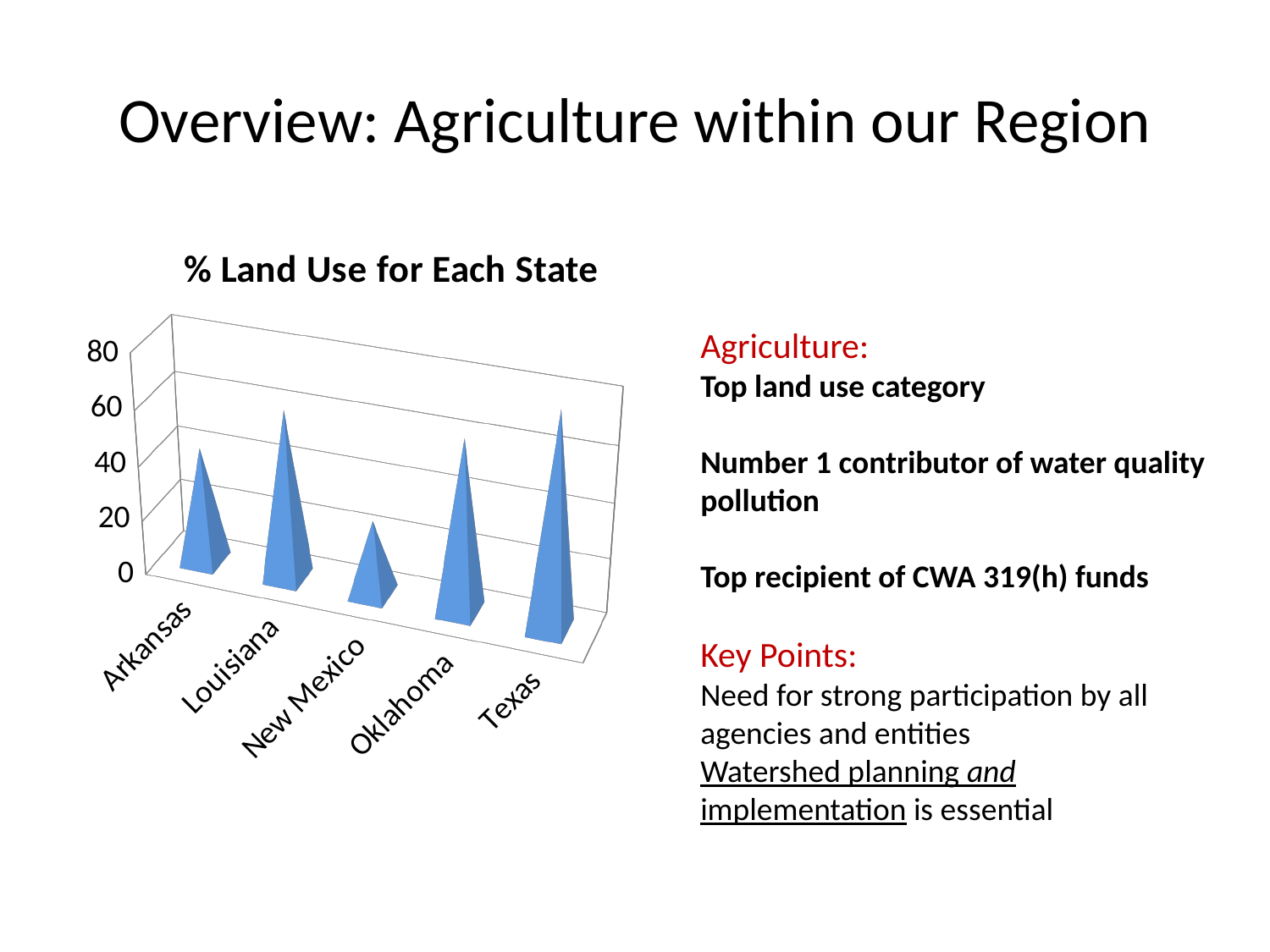
Which has the larger value, Louisiana or New Mexico? Louisiana Is the value for Texas greater or less than 40? greater What is the highest value labelled on the vertical axis of the chart? 80 Which has the larger value, Texas or Arkansas? Texas Which state has the lowest value in the chart? New Mexico Which state has the highest value in the chart? Texas Is the value for New Mexico greater or less than 40? less What kind of chart is shown on the slide? bar chart Is the value for Louisiana greater or less than 40? greater How many states are shown on the x axis of the chart? 5 What is the title of the chart? % Land Use for Each State